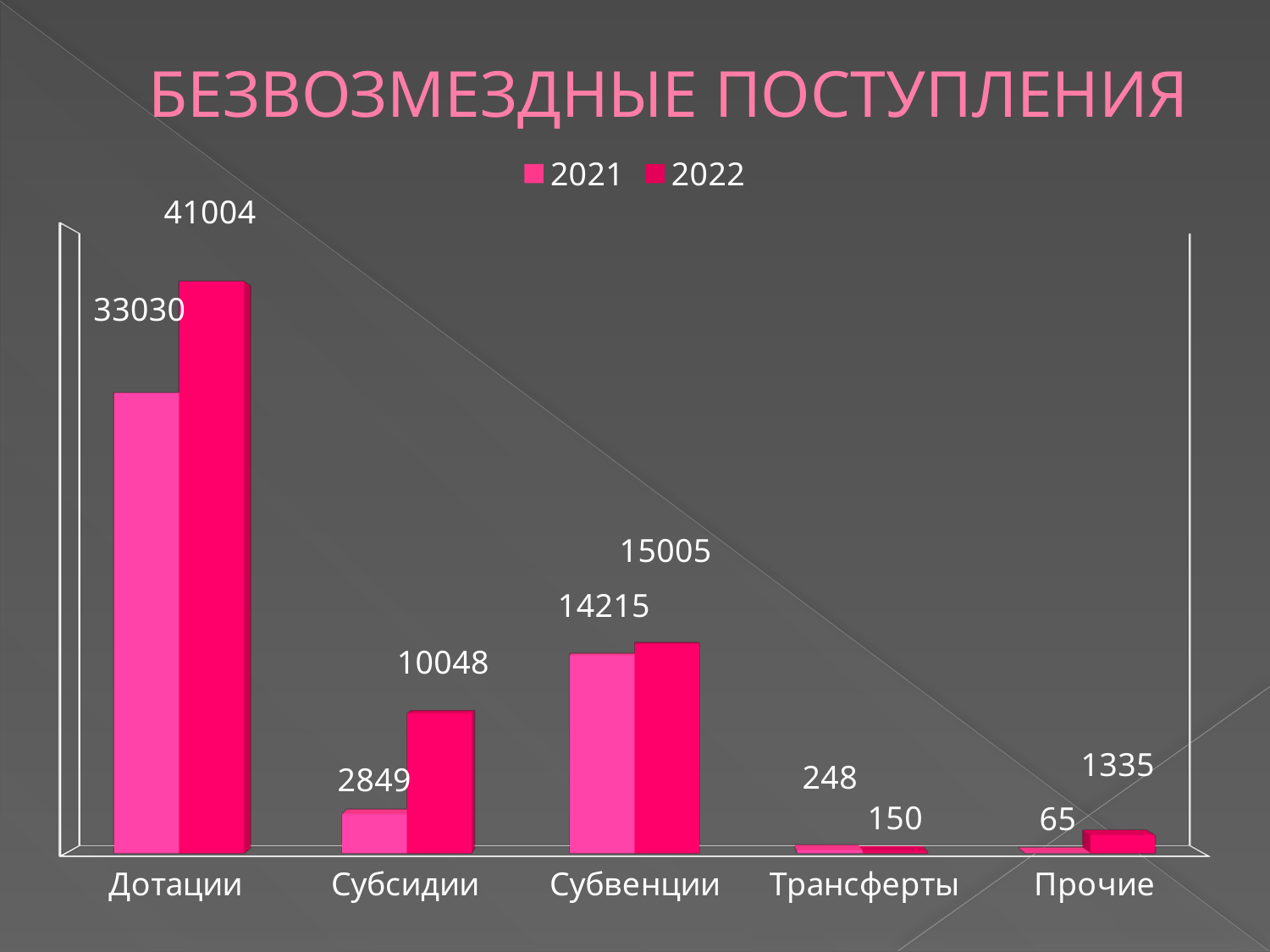
What kind of chart is shown on the slide? Bar chart Which category has the lowest value in the 2022 series? Трансферты What is the value for Трансферты in the 2021 series? 248 What is the difference between the 2022 and 2021 values for Дотации? 7974 What is the value for Дотации in the 2022 series? 41004 How many series does the legend list? 2 Which category has the highest value in the 2021 series? Дотации What is the difference between the 2022 and 2021 values for Субсидии? 7199 What is the value for Субсидии in the 2021 series? 2849 How many categories are shown on the x axis? 5 Which is larger for Трансферты: the 2021 value or the 2022 value? 2021 What is the value for Прочие in the 2022 series? 1335